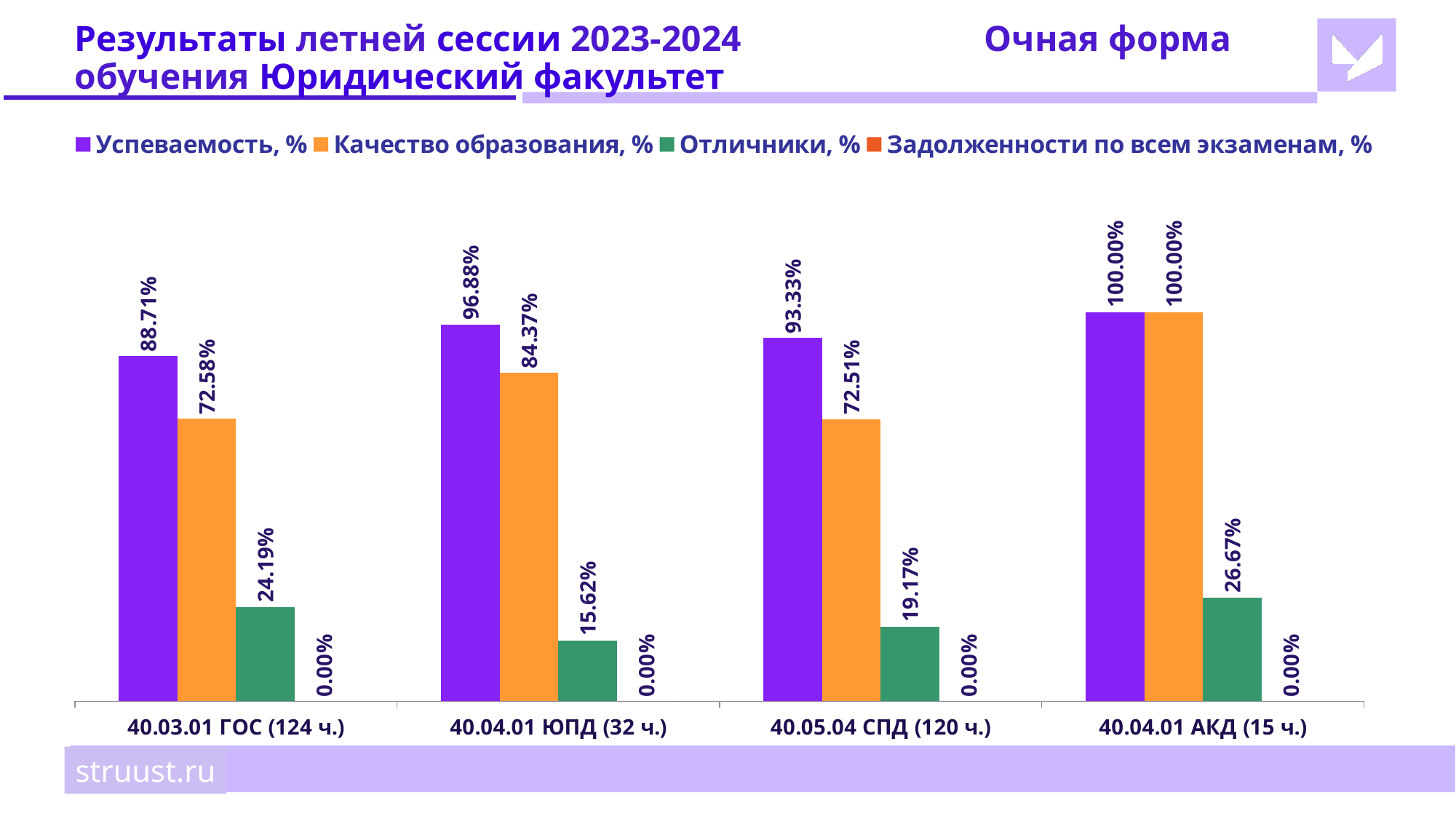
What is the value of Отличники, % for 40.05.04 СПД (120 ч.)? 19.17% How many series does the legend list? 4 Which colour represents Качество образования, % in the legend? Orange Which category has the lowest value of Успеваемость, %? 40.03.01 ГОС (124 ч.) What is the value of Качество образования, % for 40.04.01 ЮПД (32 ч.)? 84.37% What is the value of Успеваемость, % for 40.03.01 ГОС (124 ч.)? 88.71% What is the difference between Успеваемость, % and Качество образования, % for 40.04.01 ЮПД (32 ч.)? 12.51% Which is larger: Отличники, % for 40.03.01 ГОС (124 ч.) or for 40.04.01 ЮПД (32 ч.)? 40.03.01 ГОС (124 ч.) What is the value of Задолженности по всем экзаменам, % for 40.04.01 АКД (15 ч.)? 0.00% What kind of chart is shown on the slide? Bar chart Which category has the highest value of Отличники, %? 40.04.01 АКД (15 ч.) How many categories are shown on the x axis? 4